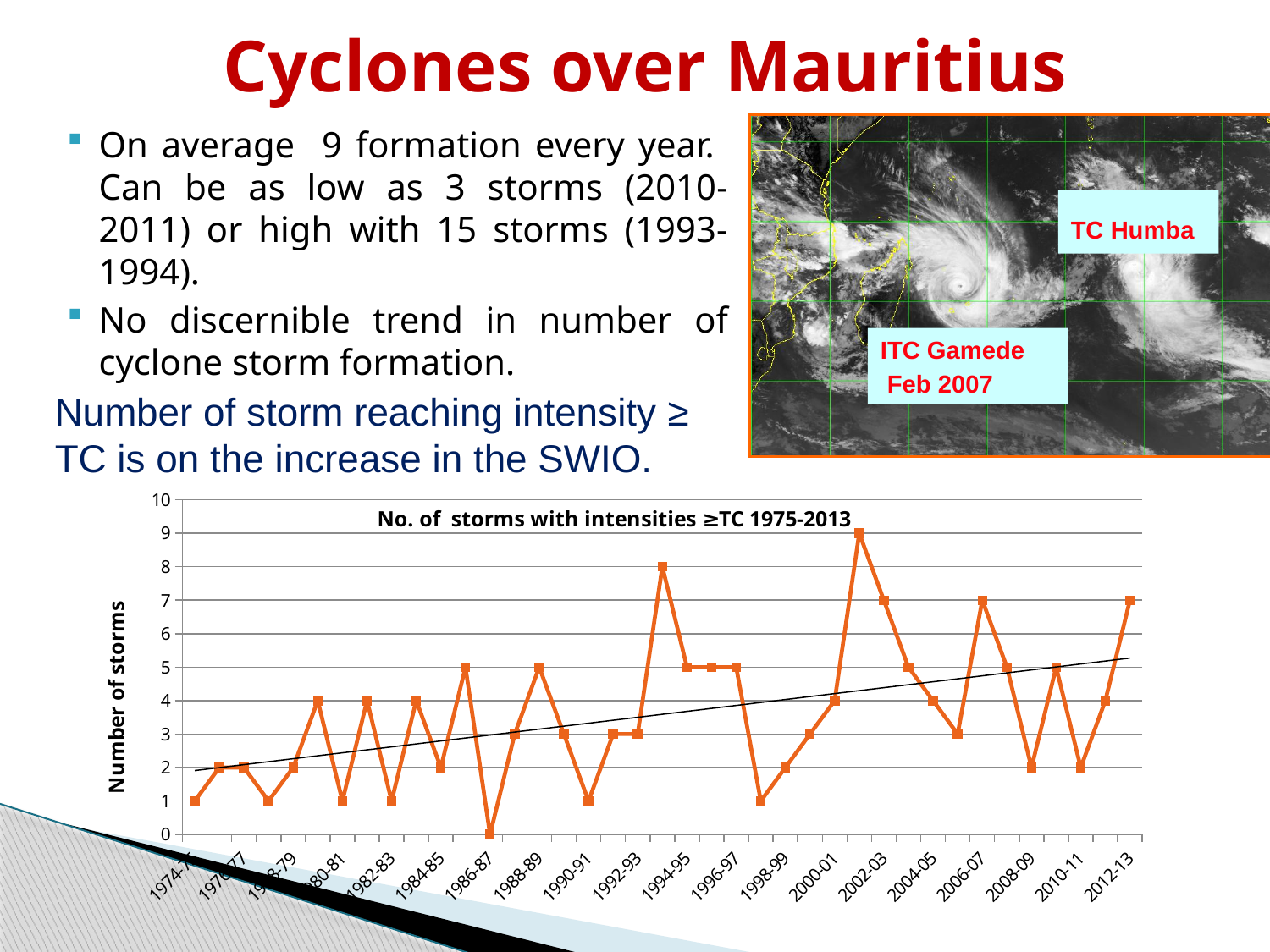
What is the difference between the highest and lowest values plotted on the chart? 9 What is the highest number of storms reached in any season on the chart? 9 Is the value for 2012-13 greater or less than 5? greater What type of chart is shown on the slide? line chart How many storms are plotted for the 2012-13 season? 7 What is the label on the vertical axis of the chart? Number of storms Does the straight trend line on the chart rise or fall from left to right? rise What is the lowest number of storms reached in any season on the chart? 0 What is the title of the chart? No. of storms with intensities ≥TC 1975-2013 How many storms are plotted for the 2010-11 season? 2 Which season has more storms, 2010-11 or 2012-13? 2012-13 How many storms are plotted for the 1986-87 season? 0